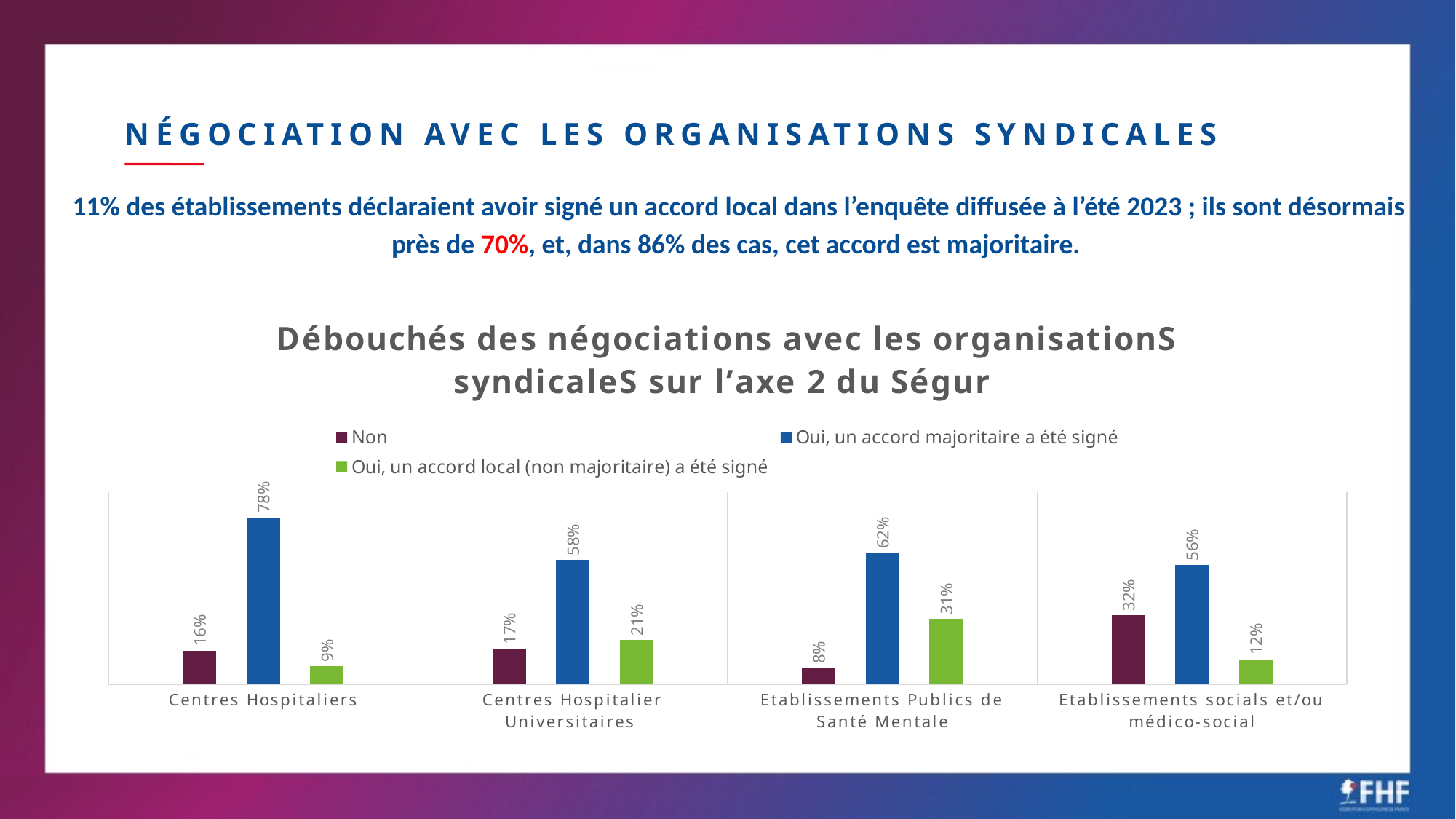
What is the value for "Non" for Etablissements Publics de Santé Mentale? 8% What is the value for "Non" for Etablissements sociaux et/ou médico-social? 32% Which category has the lowest value for "Non"? Etablissements Publics de Santé Mentale How many categories are shown on the x axis? 4 What kind of chart is shown? Bar chart What is the value for "Oui, un accord majoritaire a été signé" for Centres Hospitaliers? 78% What colour are the bars for the "Non" series? Dark purple How many series does the legend list? 3 What is the difference between the "Oui, un accord majoritaire a été signé" values for Centres Hospitaliers and Centres Hospitalier Universitaires? 20% Which category has the highest value for "Oui, un accord majoritaire a été signé"? Centres Hospitaliers Which is larger: the "Oui, un accord local (non majoritaire) a été signé" value for Etablissements Publics de Santé Mentale or for Etablissements sociaux et/ou médico-social? Etablissements Publics de Santé Mentale What is the value for "Oui, un accord local (non majoritaire) a été signé" for Centres Hospitalier Universitaires? 21%